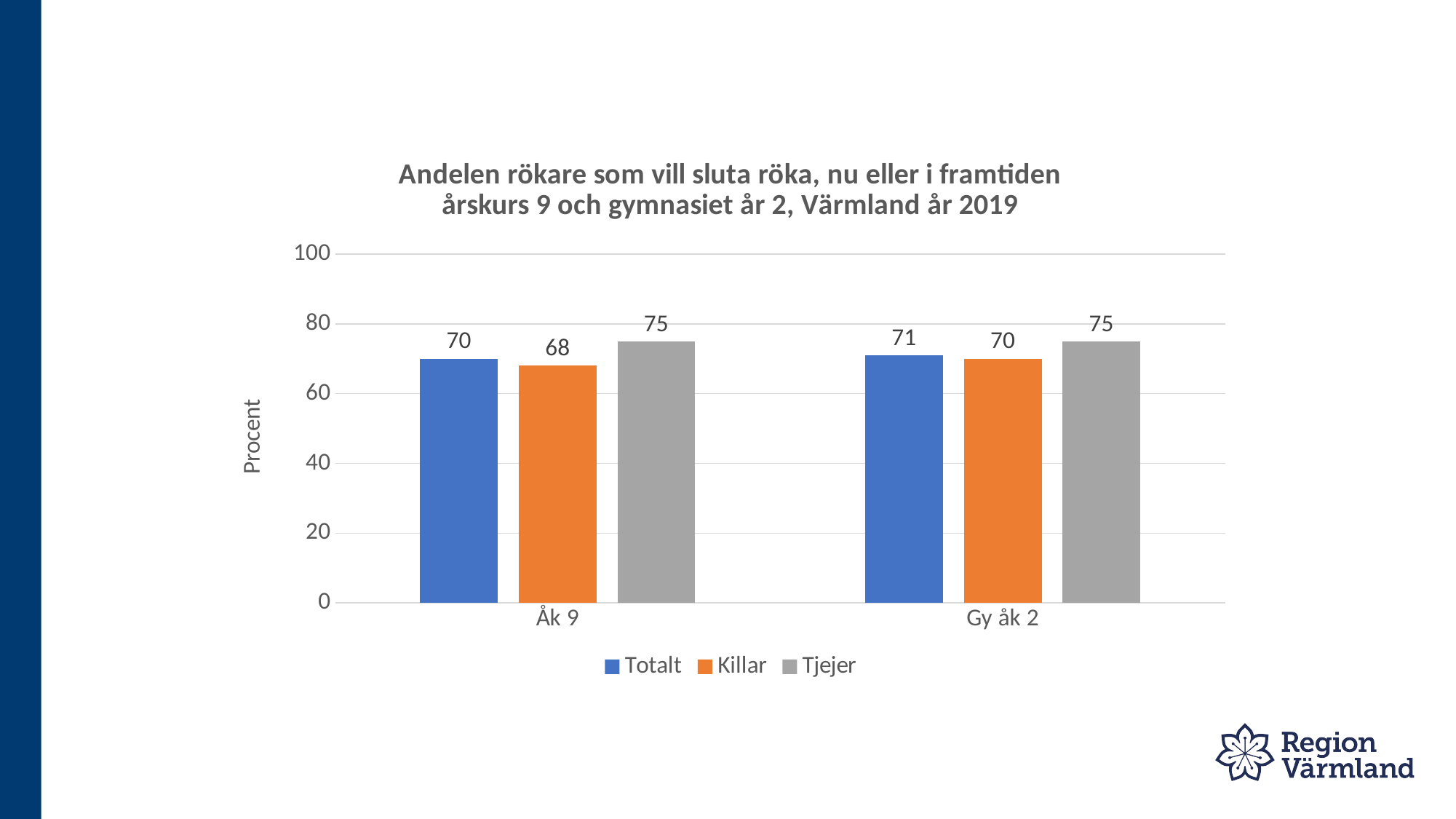
What is the label of the y axis? Procent Which series has the highest value in Åk 9? Tjejer What kind of chart is shown on the slide? Bar chart How many categories are shown on the x axis? 2 What is the value for Killar in Åk 9? 68 What is the value for Totalt in Gy åk 2? 71 How many series does the legend list? 3 Which series has the lowest value in Gy åk 2? Killar What is the value for Totalt in Åk 9? 70 What is the value for Tjejer in Gy åk 2? 75 Which is larger: Killar in Åk 9 or Killar in Gy åk 2? Killar in Gy åk 2 What is the difference between Tjejer and Killar in Åk 9? 7